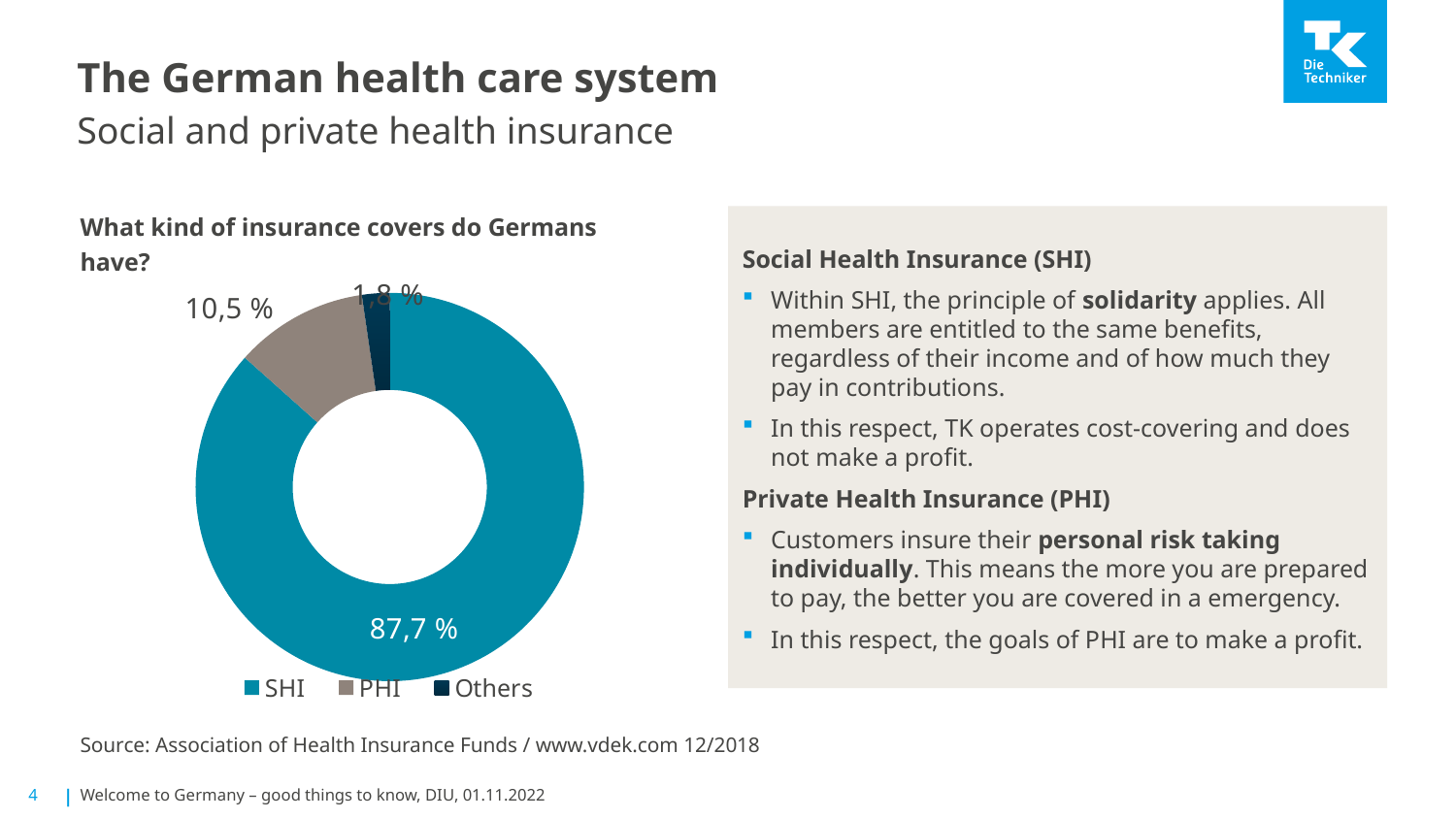
What kind of chart is shown on the slide? Doughnut (pie) chart What share of Germans are covered by SHI according to the chart? 87,7 % Which insurance type has the largest share in the chart? SHI What is the title of the chart on the slide? What kind of insurance covers do Germans have? What share of Germans are covered by PHI according to the chart? 10,5 % What share does the Others slice represent in the chart? 1,8 % Which is larger, the share for PHI or the share for Others? PHI Which insurance type has the smallest share in the chart? Others What is the difference in percentage points between the SHI share and the PHI share? 77,2 How many categories are shown in the chart? 3 Which legend entries are listed below the chart? SHI, PHI, Others What is the difference in percentage points between the PHI share and the Others share? 8,7